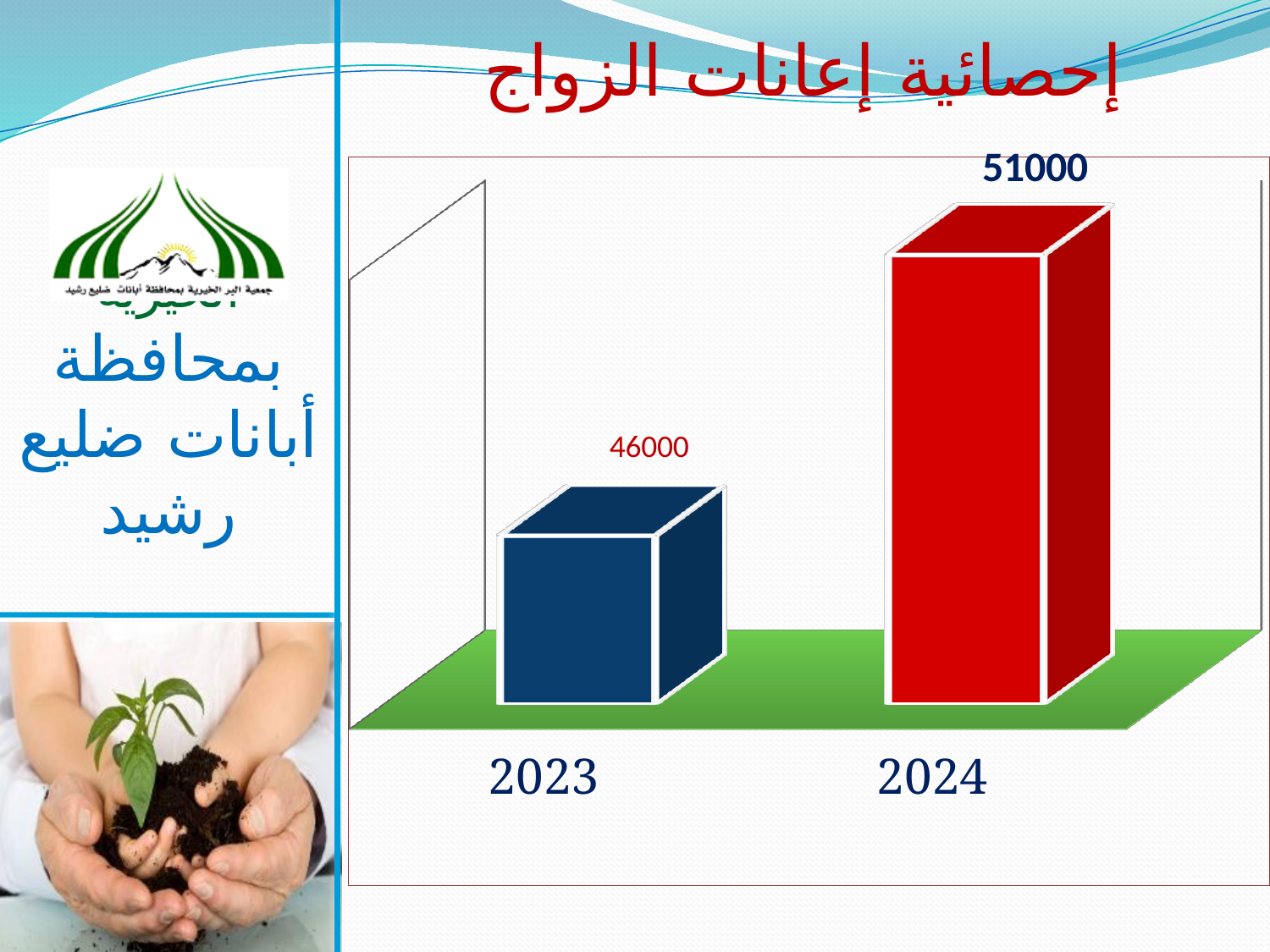
Do the values rise or fall from 2023 to 2024? Rise Which is larger, the value for 2023 or the value for 2024? 2024 What kind of chart is shown on the slide? Bar chart Which year has the highest value? 2024 How many categories are shown on the x axis? 2 What is the value shown for 2023? 46000 What is the difference between the values for 2024 and 2023? 5000 What is the value shown for 2024? 51000 What is the title of the chart? إحصائية إعانات الزواج Which year has the lowest value? 2023 What colour is the bar for 2024? Red